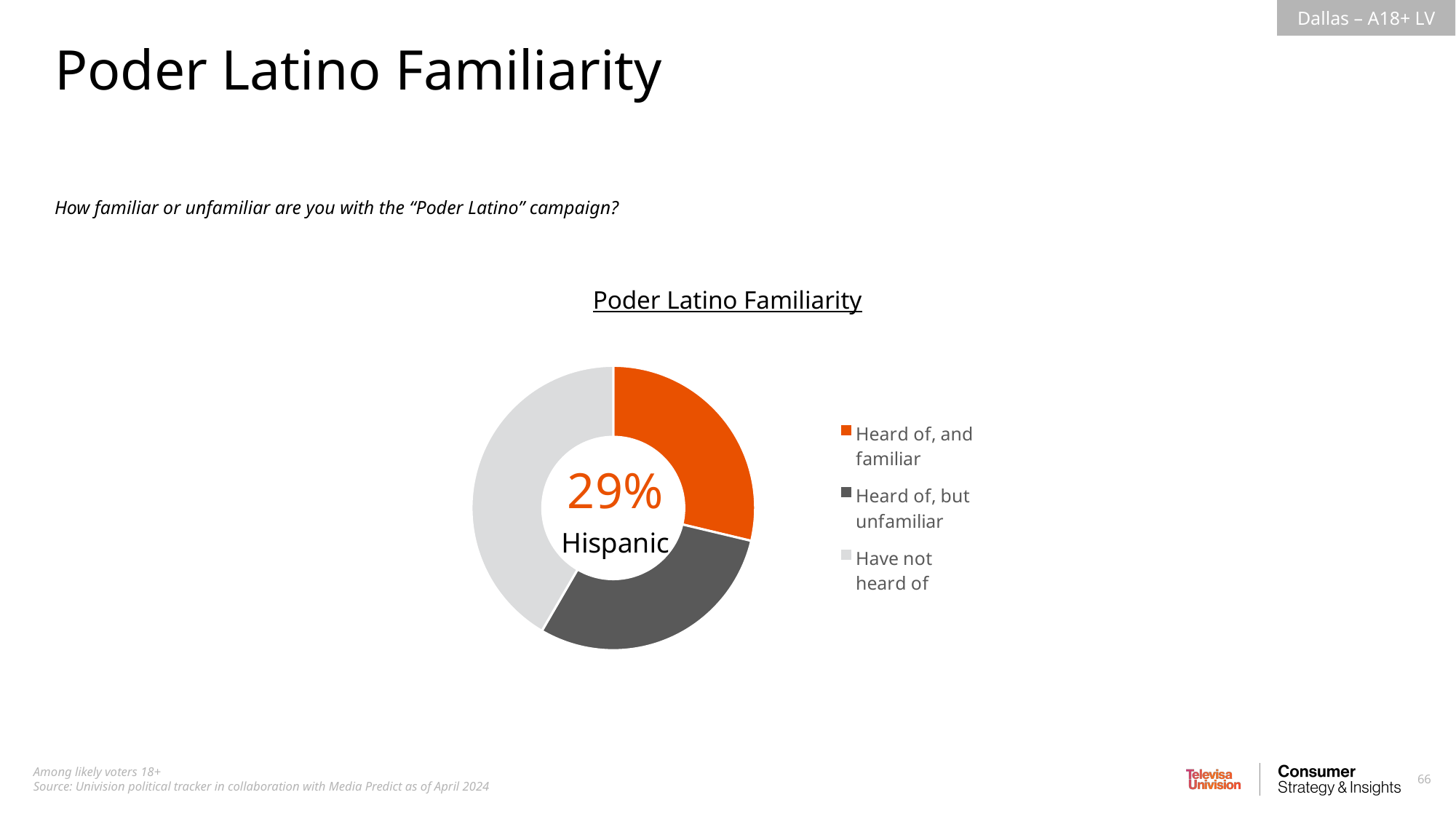
What share of the pie does the 'Heard of, and familiar' slice represent? 29% Is the 'Have not heard of' slice greater or less than 25% of the pie? greater What percentage is printed in the center of the Poder Latino Familiarity chart? 29% Which slice is larger: 'Heard of, and familiar' or 'Have not heard of'? Have not heard of What group label is printed inside the donut chart below the percentage? Hispanic How many slices does the donut chart have? 3 What is the chart type used on the slide? Pie chart (donut) Which legend entry is shown in orange? Heard of, and familiar Is the 'Heard of, and familiar' slice greater or less than 50% of the pie? less How many categories does the legend of the Poder Latino Familiarity chart list? 3